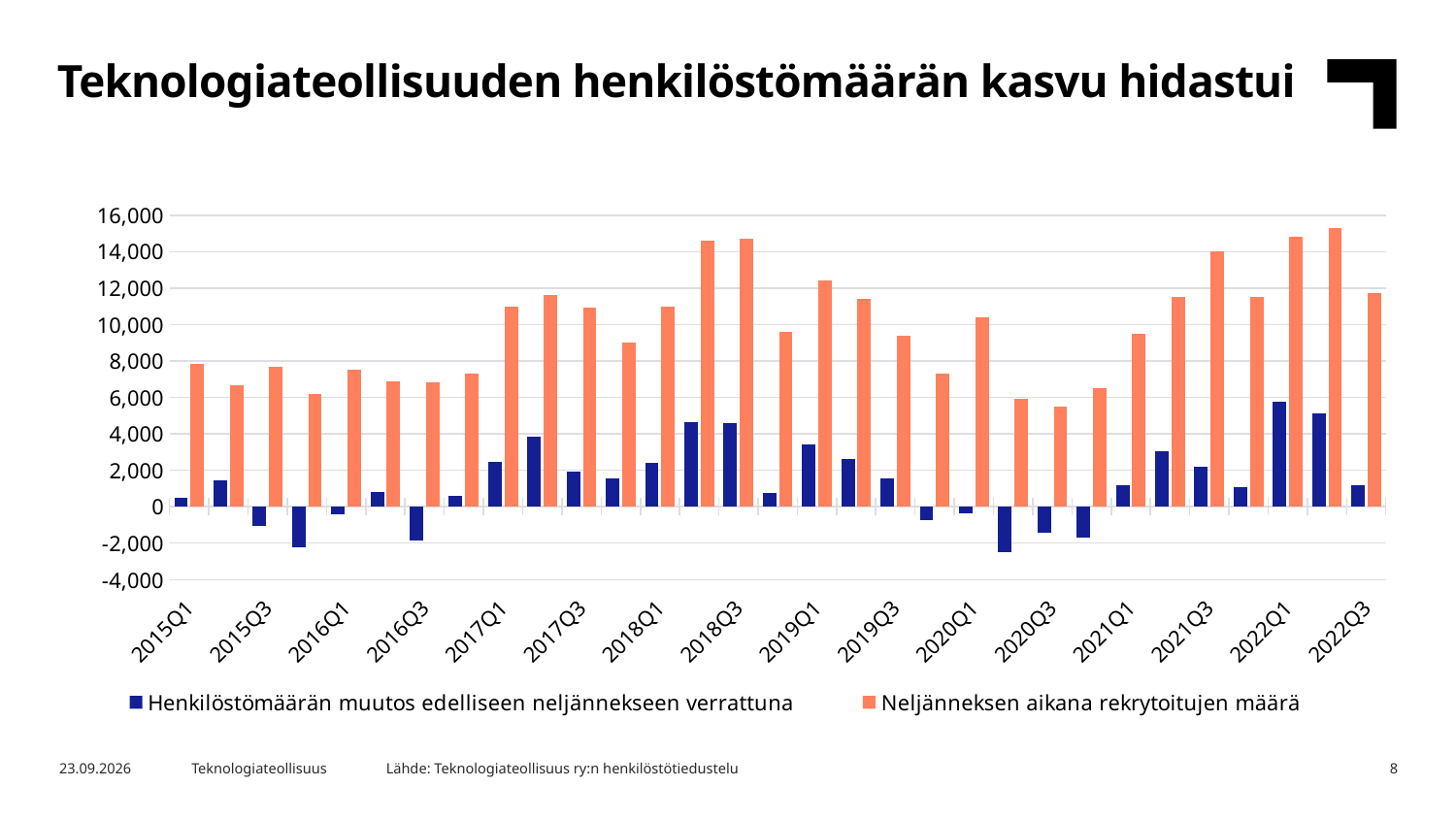
Which quarter has the highest value of 'Henkilöstömäärän muutos edelliseen neljännekseen verrattuna'? 2022Q1 Does the 'Neljänneksen aikana rekrytoitujen määrä' series generally rise or fall from 2020Q3 to 2022Q2? rise Is the value of 'Neljänneksen aikana rekrytoitujen määrä' for 2018Q3 greater or less than 14,000? greater What kind of chart is shown on the slide? Bar chart Is the value of 'Henkilöstömäärän muutos edelliseen neljännekseen verrattuna' for 2020Q2 greater or less than -2,000? less How many quarters (category pairs of bars) are plotted in the chart? 31 What is the title of the slide containing the chart? Teknologiateollisuuden henkilöstömäärän kasvu hidastui How many series does the legend list? 2 Is the value of 'Neljänneksen aikana rekrytoitujen määrä' for 2020Q3 greater or less than 6,000? less Which is larger, the 'Neljänneksen aikana rekrytoitujen määrä' value for 2018Q3 or for 2019Q3? 2018Q3 Which legend entry is shown in orange? Neljänneksen aikana rekrytoitujen määrä